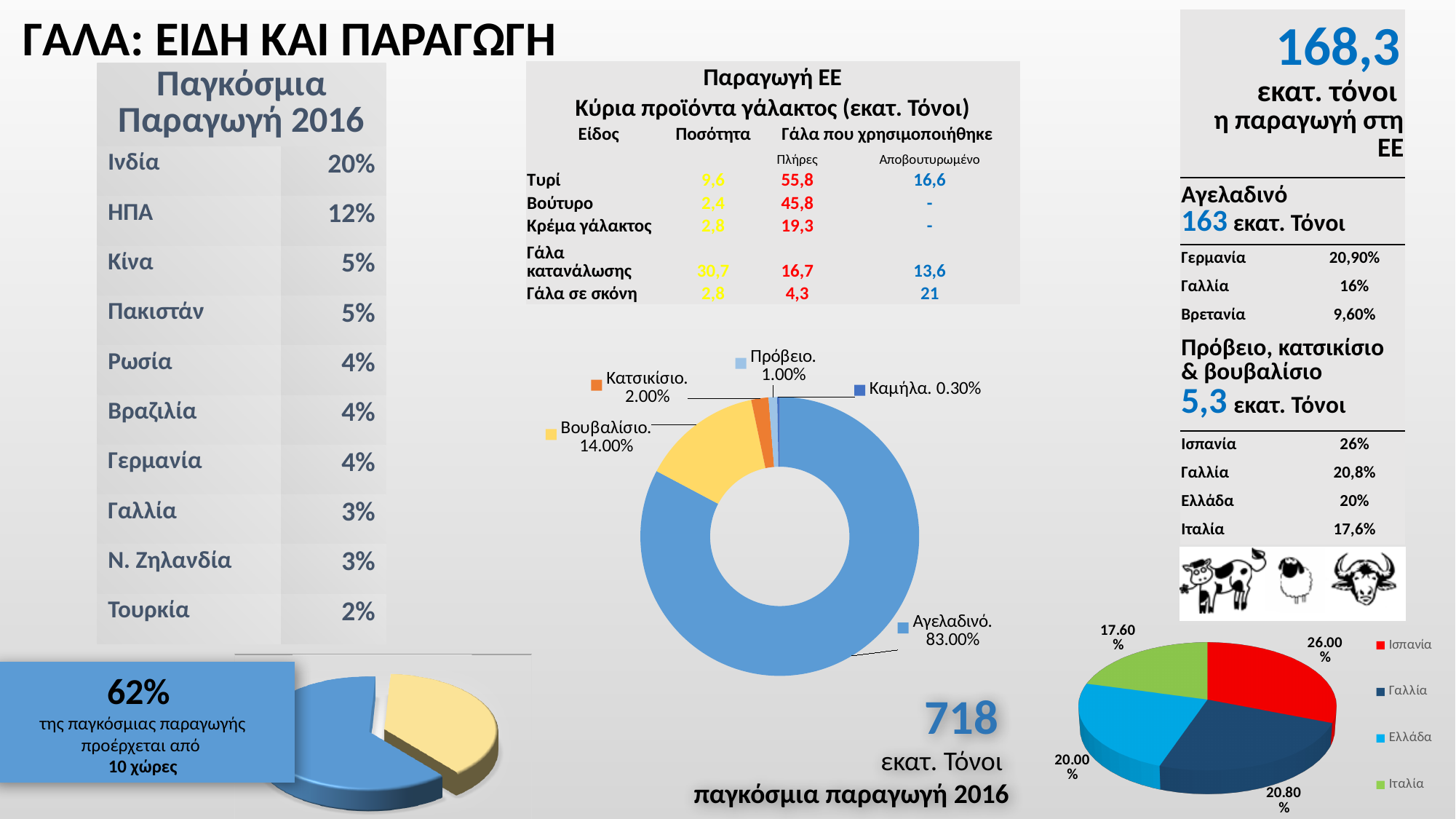
In the centre doughnut chart, which milk type has the largest share? Αγελαδινό What kind of chart is the bottom-right chart with the country legend? Pie chart In the centre doughnut chart, which has the larger share, Κατσικίσιο or Πρόβειο? Κατσικίσιο In the centre doughnut chart, what percentage is shown for Βουβαλίσιο? 14.00% What kind of chart is the centre chart showing milk types? Doughnut chart In the centre doughnut chart, what is the difference between the shares of Αγελαδινό and Βουβαλίσιο? 69.00% How many categories are shown in the centre doughnut chart? 5 In the centre doughnut chart, which milk type has the smallest share? Καμήλα In the bottom-right pie chart, which country has the largest slice? Ισπανία In the bottom-right pie chart, which country has the smallest slice? Ιταλία How many entries does the legend of the bottom-right pie chart list? 4 In the bottom-right pie chart, what percentage is shown for Ελλάδα? 20.00%